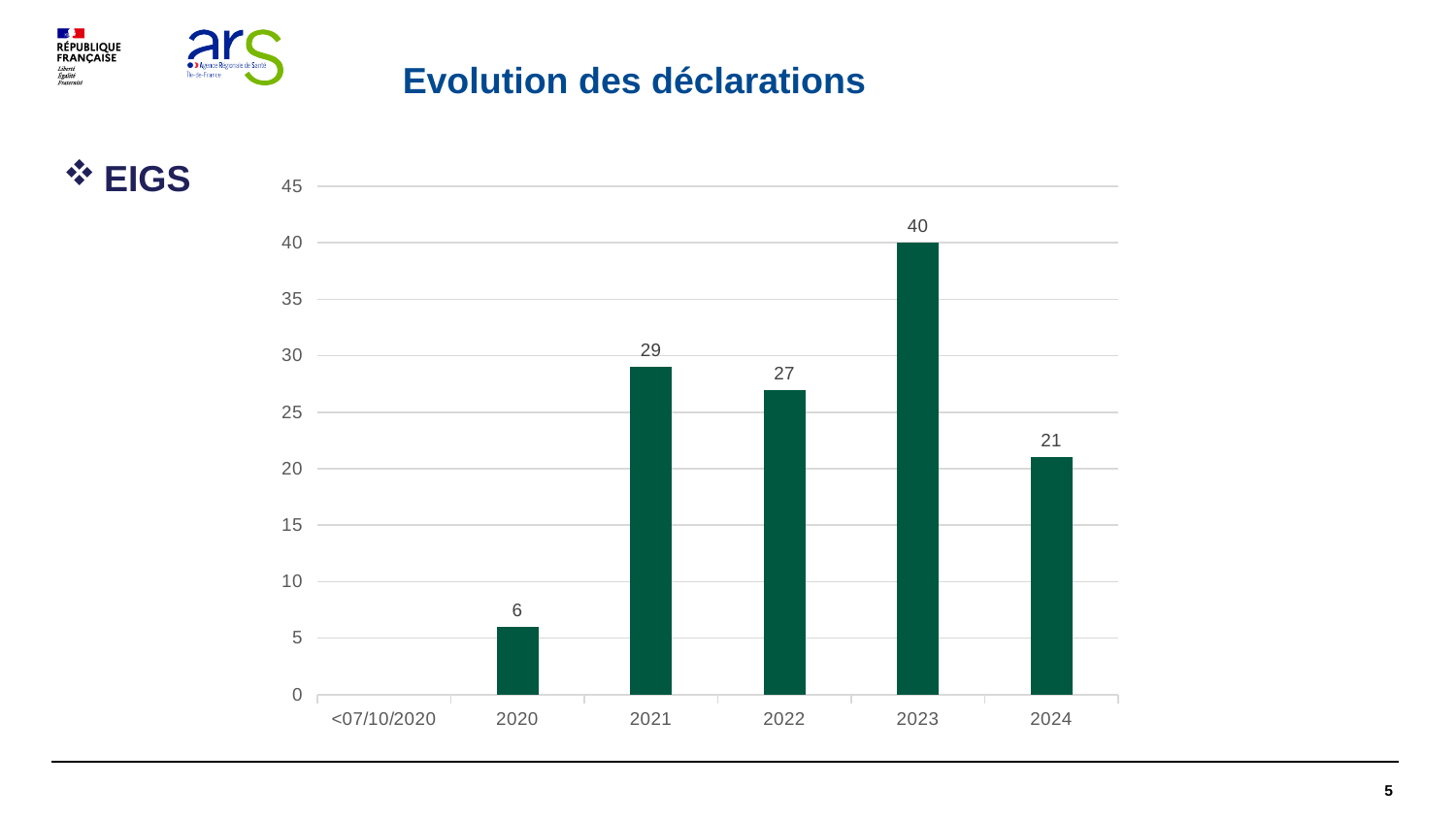
What is the title of the slide? Evolution des déclarations What is the difference between the values for 2021 and 2022? 2 What kind of chart is shown on the slide? bar chart What is the value for 2023? 40 How many categories are shown on the x axis? 6 Which labelled bar has the lowest value? 2020 What is the value for 2024? 21 Is the value for 2022 greater or less than 25? greater What is the value for 2020? 6 What is the difference between the values for 2023 and 2024? 19 Which is larger, the value for 2021 or the value for 2022? 2021 Which year has the highest value? 2023